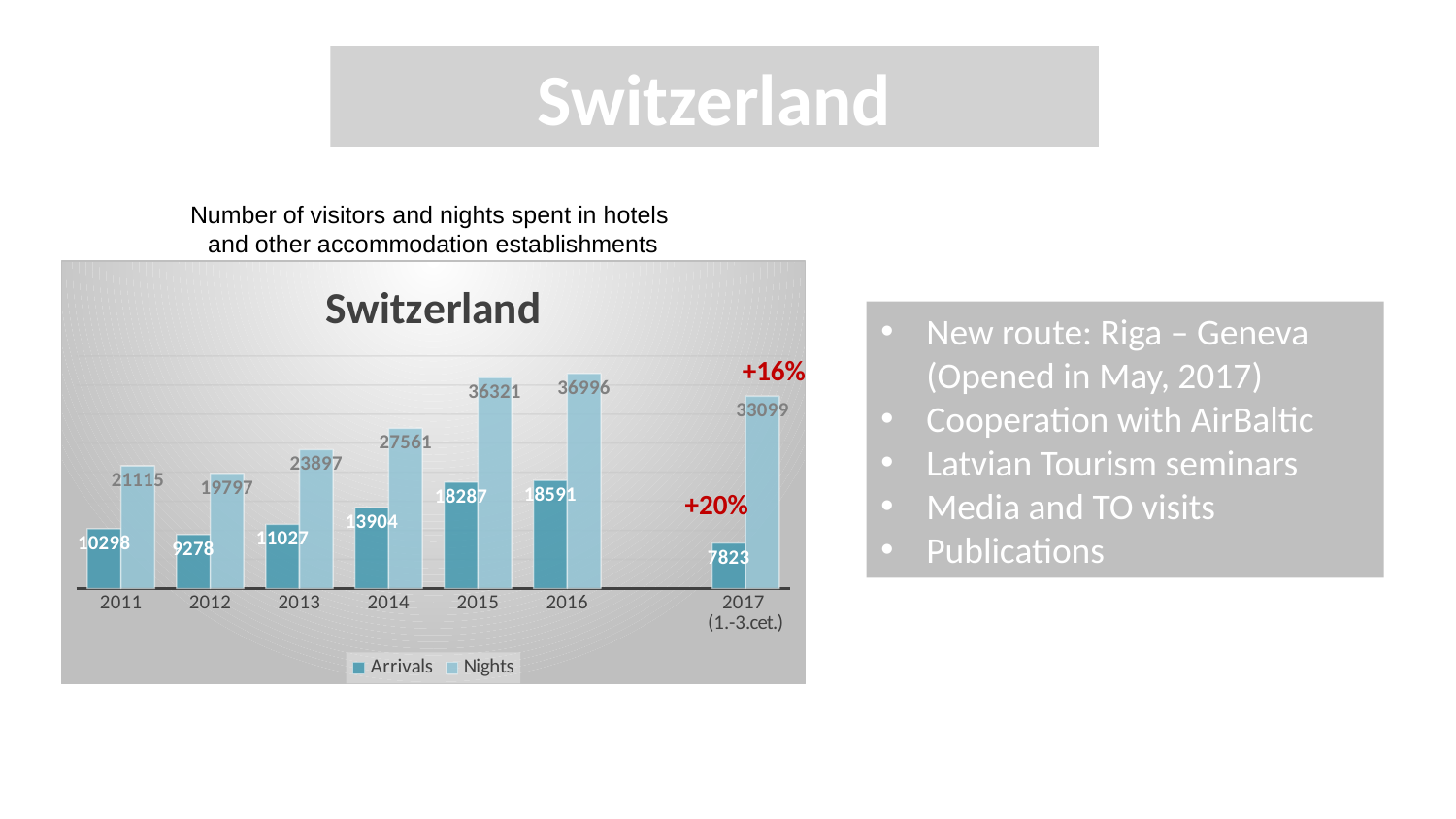
What is the difference between Nights and Arrivals in 2014? 13657 Which year has the highest value for Nights? 2016 What is the value for Nights in 2017 (1.-3.cet.)? 33099 What is the difference between Arrivals in 2016 and Arrivals in 2015? 304 What is the value for Nights in 2013? 23897 How many series does the legend list? 2 Which is larger, Arrivals in 2011 or Arrivals in 2012? Arrivals in 2011 What kind of chart is shown? bar chart What percentage change is annotated in red above the Nights bar for 2017? +16% What is the value for Arrivals in 2015? 18287 How many years are shown on the x axis? 7 Which year has the lowest value for Arrivals? 2017 (1.-3.cet.)